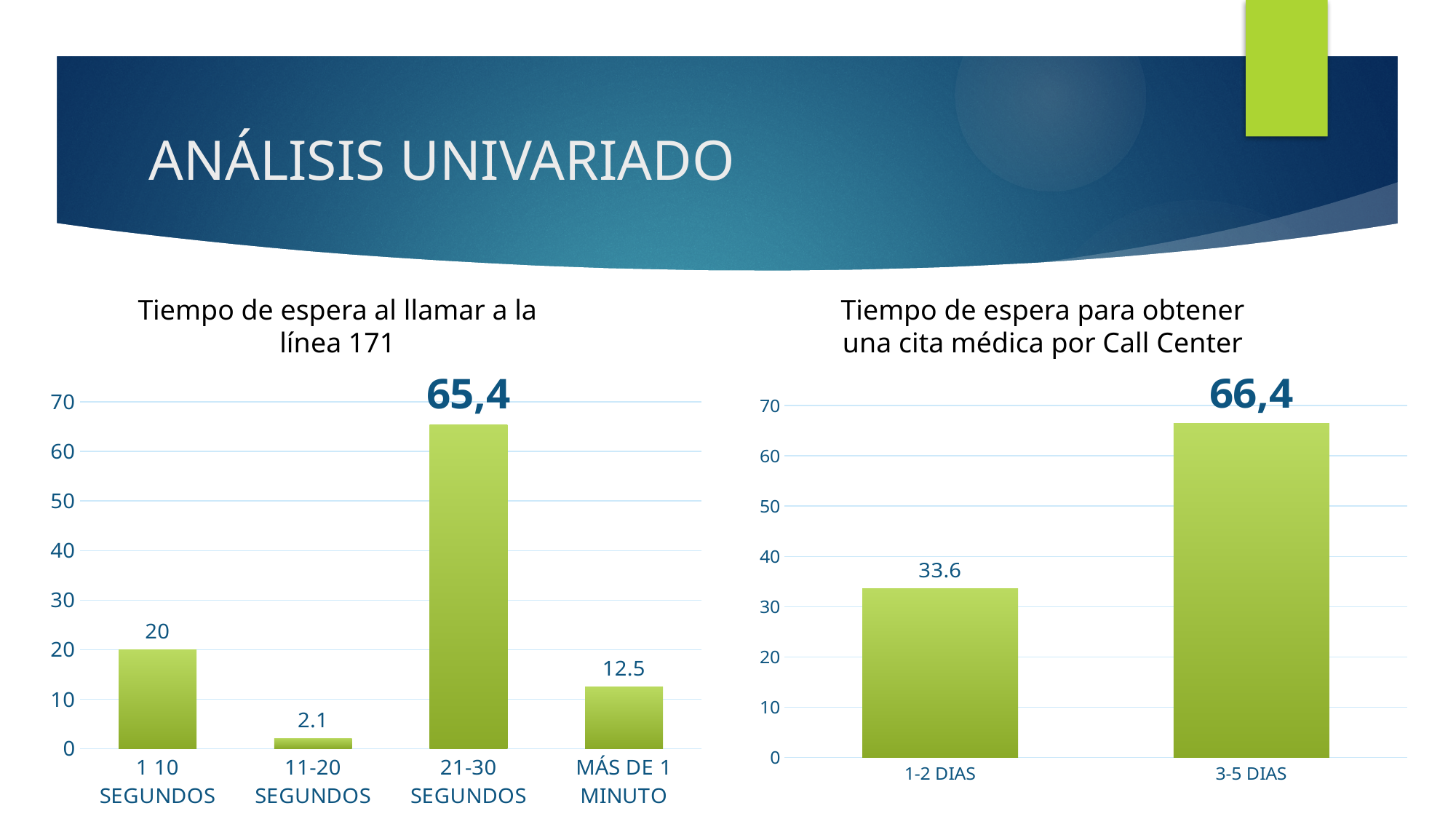
In the chart 'Tiempo de espera para obtener una cita médica por Call Center', what is the value for 1-2 DIAS? 33.6 In the chart 'Tiempo de espera para obtener una cita médica por Call Center', what is the value for 3-5 DIAS? 66,4 In the chart 'Tiempo de espera al llamar a la línea 171', what is the difference between the values for 1 10 SEGUNDOS and MÁS DE 1 MINUTO? 7.5 In the chart 'Tiempo de espera al llamar a la línea 171', what is the value for 11-20 SEGUNDOS? 2.1 In the chart 'Tiempo de espera al llamar a la línea 171', which category has the highest value? 21-30 SEGUNDOS In the chart 'Tiempo de espera al llamar a la línea 171', what is the value for MÁS DE 1 MINUTO? 12.5 In the chart 'Tiempo de espera al llamar a la línea 171', what is the value for 21-30 SEGUNDOS? 65,4 What kind of chart is the chart on the right of the slide? Bar chart In the chart 'Tiempo de espera al llamar a la línea 171', which category has the lowest value? 11-20 SEGUNDOS What is the title of the chart on the left of the slide? Tiempo de espera al llamar a la línea 171 In the chart 'Tiempo de espera al llamar a la línea 171', how many categories are shown? 4 In the chart 'Tiempo de espera para obtener una cita médica por Call Center', which category has the larger value, 1-2 DIAS or 3-5 DIAS? 3-5 DIAS